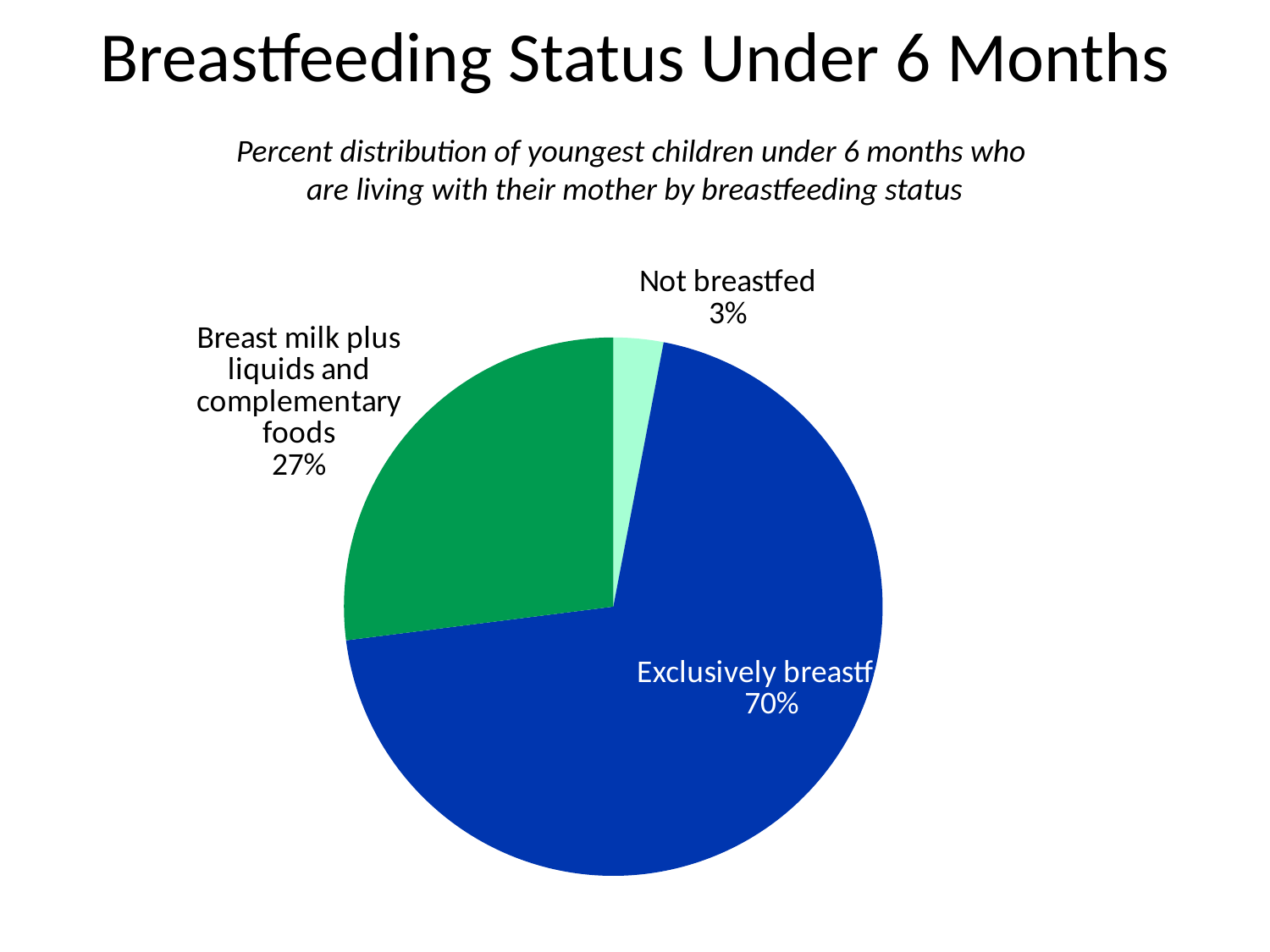
What is the title of the slide? Breastfeeding Status Under 6 Months Which is larger: the share of children exclusively breastfed or the share receiving breast milk plus liquids and complementary foods? Exclusively breastfed What is the difference in percentage points between the exclusively breastfed share and the breast milk plus liquids and complementary foods share? 43 What colour is the slice representing exclusively breastfed children? Blue How many categories are shown in the pie chart? 3 What percentage of children under 6 months are exclusively breastfed? 70% What percentage of children under 6 months are not breastfed? 3% What type of chart is shown on the slide? Pie chart What is the difference in percentage points between the breast milk plus liquids and complementary foods share and the not breastfed share? 24 What percentage of children under 6 months receive breast milk plus liquids and complementary foods? 27% Which breastfeeding status category has the largest share of the pie? Exclusively breastfed Which breastfeeding status category has the smallest share of the pie? Not breastfed